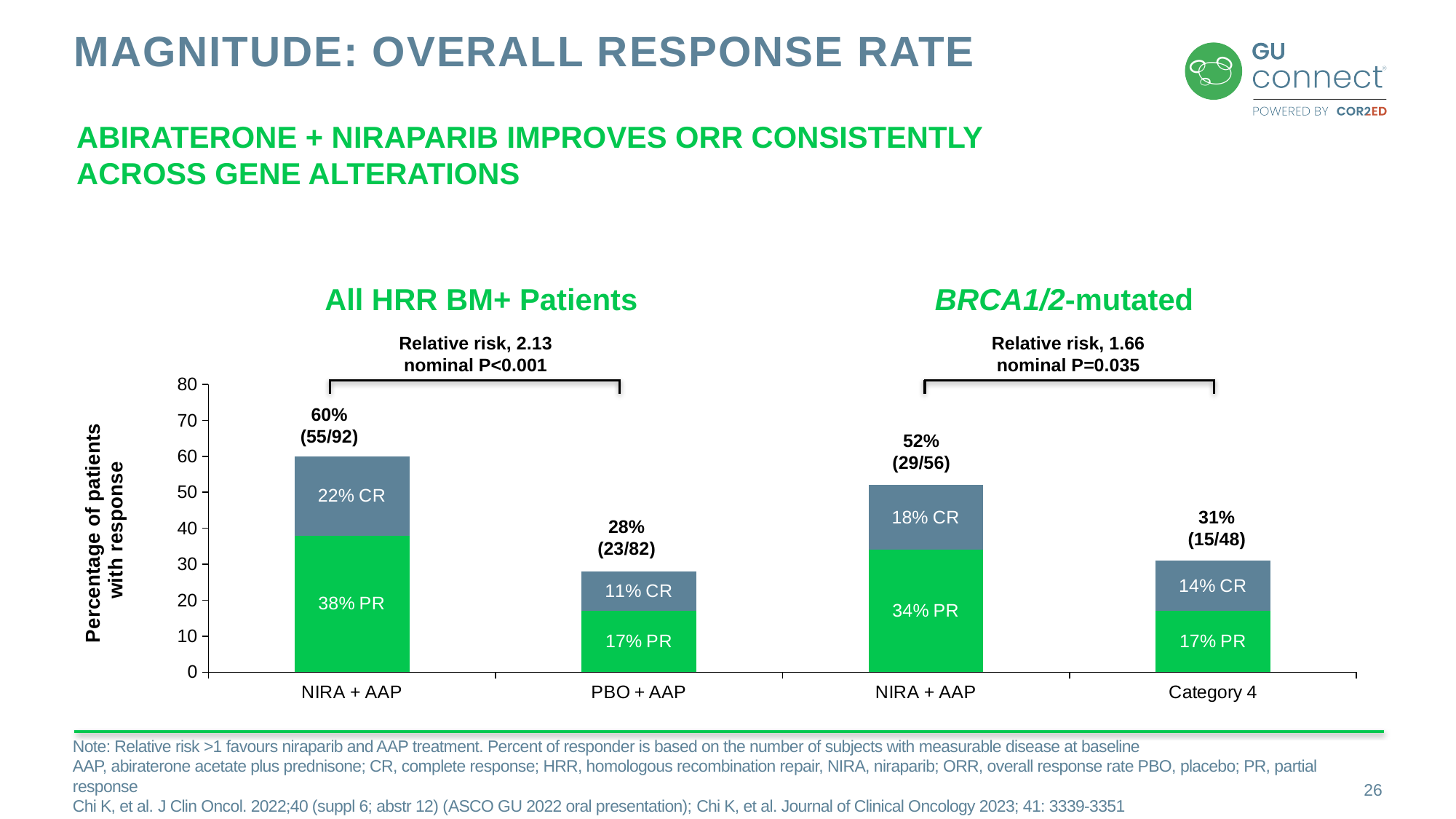
How many bars are plotted in the chart? 4 Which bar has the highest overall response rate? NIRA + AAP (All HRR BM+ Patients), 60% What is the label on the y axis of the chart? Percentage of patients with response What is the difference in overall response rate between NIRA + AAP and PBO + AAP in the All HRR BM+ Patients group? 32 percentage points Which bar has the lowest overall response rate? PBO + AAP, 28% What is the CR percentage in the PBO + AAP bar? 11% CR Which is larger, the CR percentage for NIRA + AAP in the BRCA1/2-mutated group or the CR percentage for Category 4? NIRA + AAP (18% CR) What is the overall response rate shown above the NIRA + AAP bar in the All HRR BM+ Patients group? 60% What is the overall response rate shown above the bar labelled Category 4? 31% What is the relative risk shown for the All HRR BM+ Patients comparison? 2.13 What is the PR percentage in the NIRA + AAP bar of the BRCA1/2-mutated group? 34% PR What kind of chart is shown on the slide? Stacked bar chart